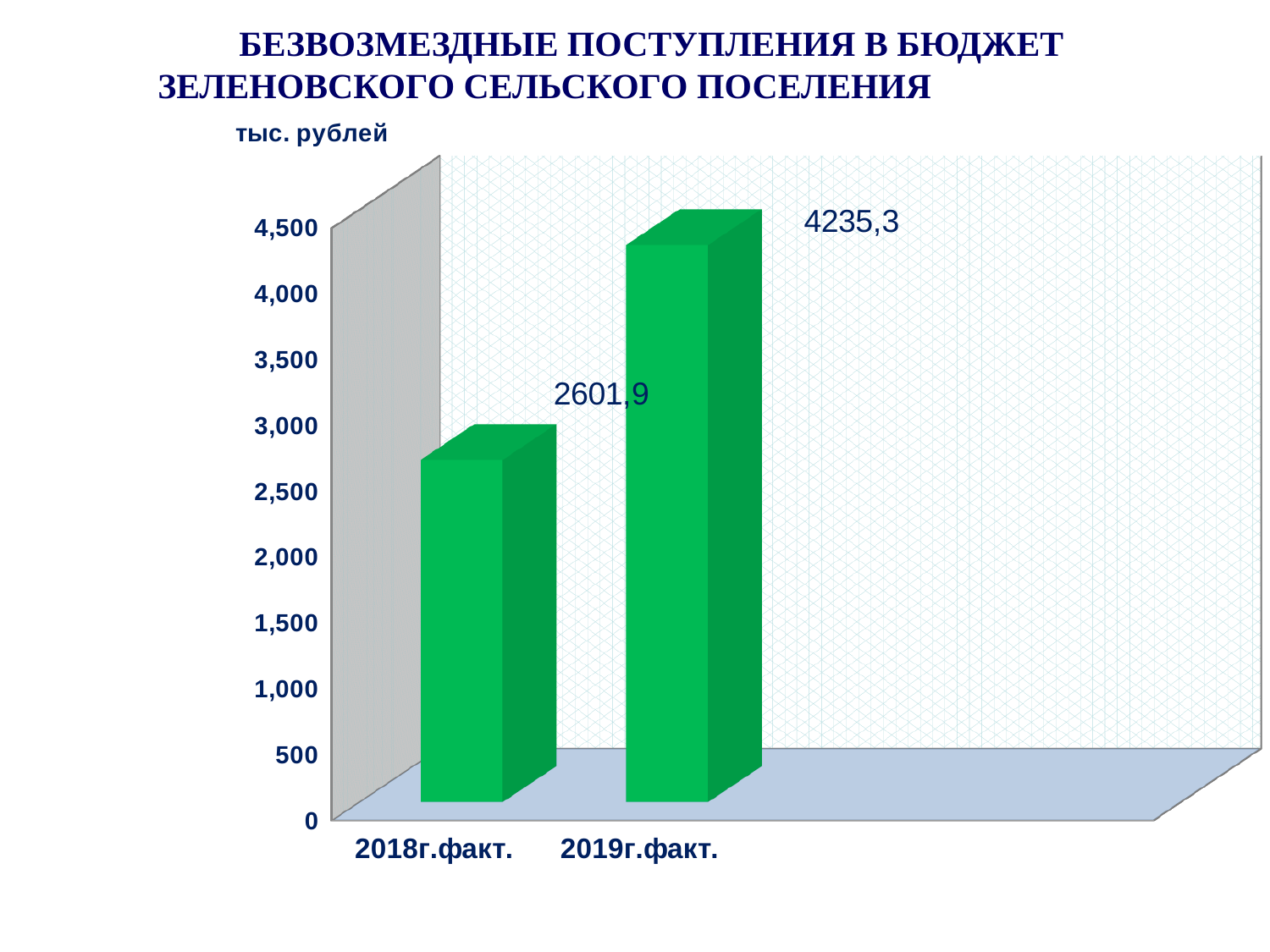
What unit of measurement is indicated above the chart? тыс. рублей Which category has the lowest value? 2018г.факт. Do the values rise or fall from 2018г.факт. to 2019г.факт.? rise Is the value for 2018г.факт. greater or less than 3,000? less What is the value for 2018г.факт.? 2601,9 How many categories are shown on the x axis? 2 Which category has the highest value? 2019г.факт. What is the value for 2019г.факт.? 4235,3 Is the value for 2019г.факт. greater or less than 4,000? greater What is the difference between the values for 2019г.факт. and 2018г.факт.? 1633,4 Which is larger, the value for 2018г.факт. or the value for 2019г.факт.? 2019г.факт. What kind of chart is shown on the slide? bar chart